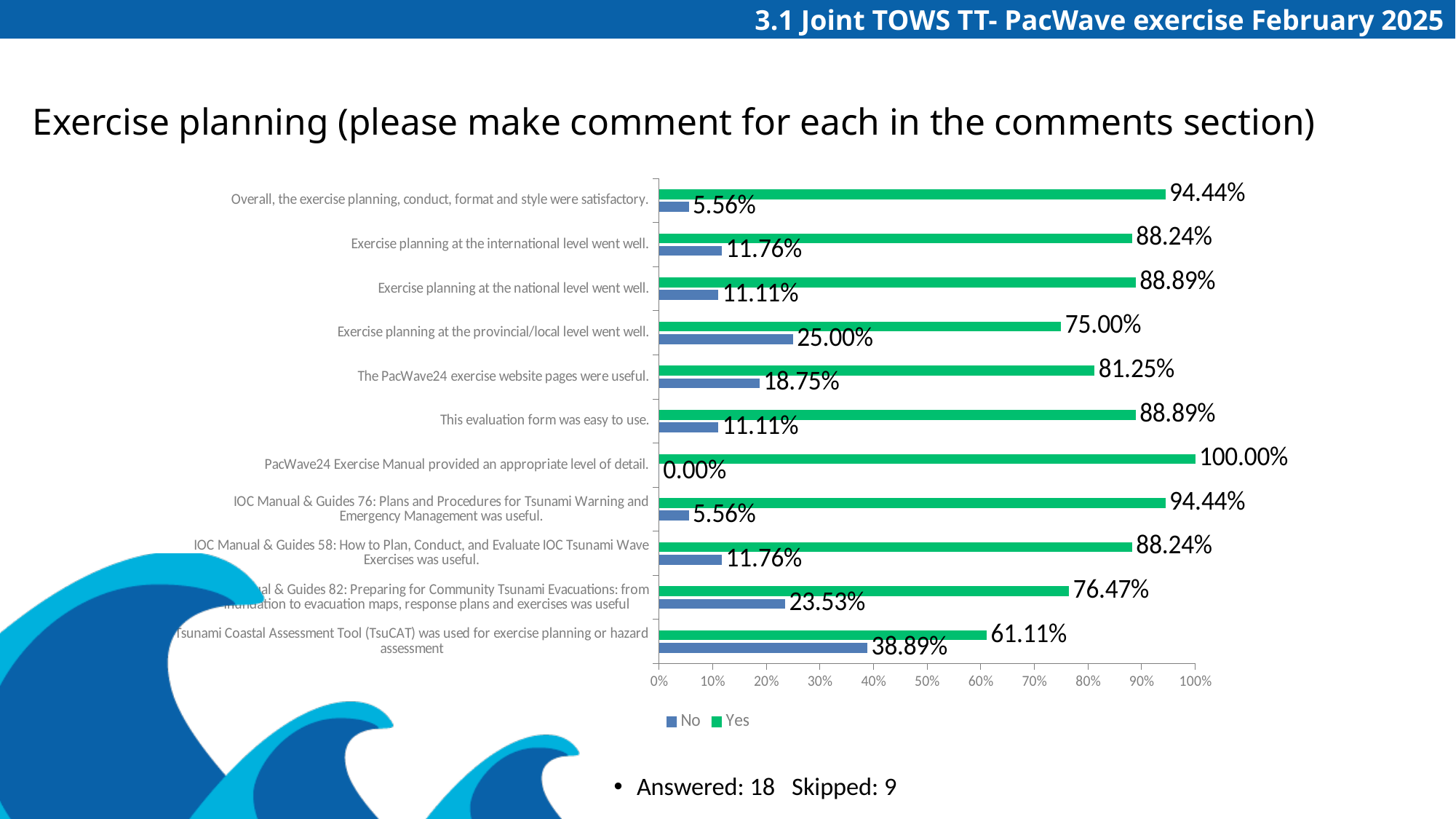
What is the Yes value for "The PacWave24 exercise website pages were useful."? 81.25% What is the difference between the Yes and No values for "Exercise planning at the international level went well."? 76.48% Which statement has the lowest Yes value? Tsunami Coastal Assessment Tool (TsuCAT) was used for exercise planning or hazard assessment How many series does the legend list? 2 Which statement has the highest Yes value? PacWave24 Exercise Manual provided an appropriate level of detail. Which colour represents the Yes series in the chart? green How many categories (statements) are plotted in the chart? 11 What kind of chart is shown on the slide? bar chart What is the Yes value for "PacWave24 Exercise Manual provided an appropriate level of detail."? 100.00% Which has a larger No value: "Exercise planning at the national level went well." or "The PacWave24 exercise website pages were useful."? The PacWave24 exercise website pages were useful. What is the No value for "Exercise planning at the provincial/local level went well."? 25.00% What is the No value for "Tsunami Coastal Assessment Tool (TsuCAT) was used for exercise planning or hazard assessment"? 38.89%